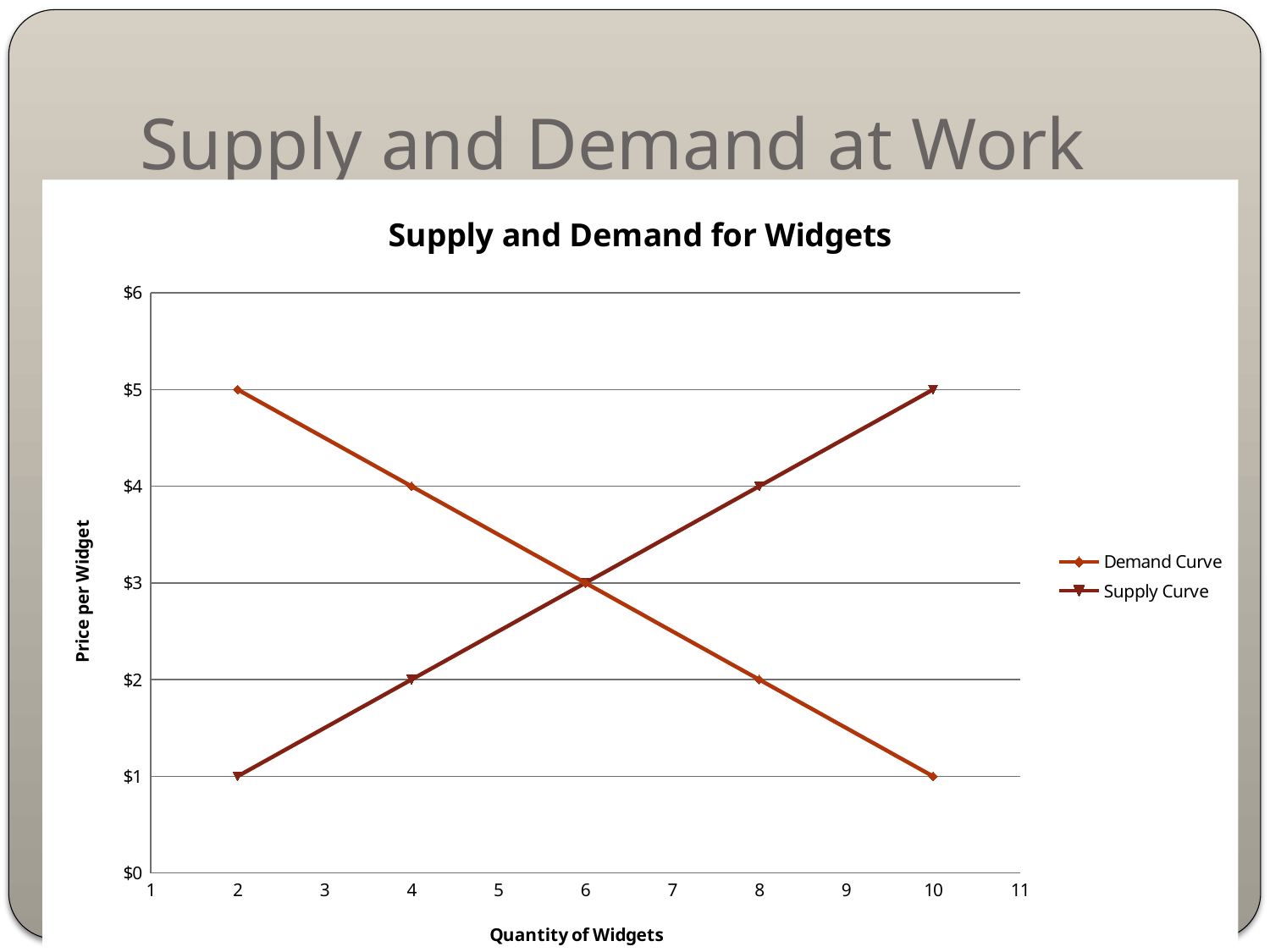
What kind of chart is shown on the slide? Line chart At a quantity of 8, which is higher: the Demand Curve or the Supply Curve? Supply Curve Does the Demand Curve rise or fall as the quantity of widgets increases? Fall What is the difference between the Supply Curve price and the Demand Curve price at a quantity of 10? $4 At what price do the Demand Curve and Supply Curve intersect? $3 What is the title of the chart? Supply and Demand for Widgets What is the price per widget on the Supply Curve at a quantity of 10? $5 How many series does the legend list? 2 Does the Supply Curve rise or fall as the quantity of widgets increases? Rise How many data points are plotted on the Demand Curve? 5 What is the price per widget on the Demand Curve at a quantity of 2? $5 At what quantity of widgets do the Demand Curve and Supply Curve intersect? 6